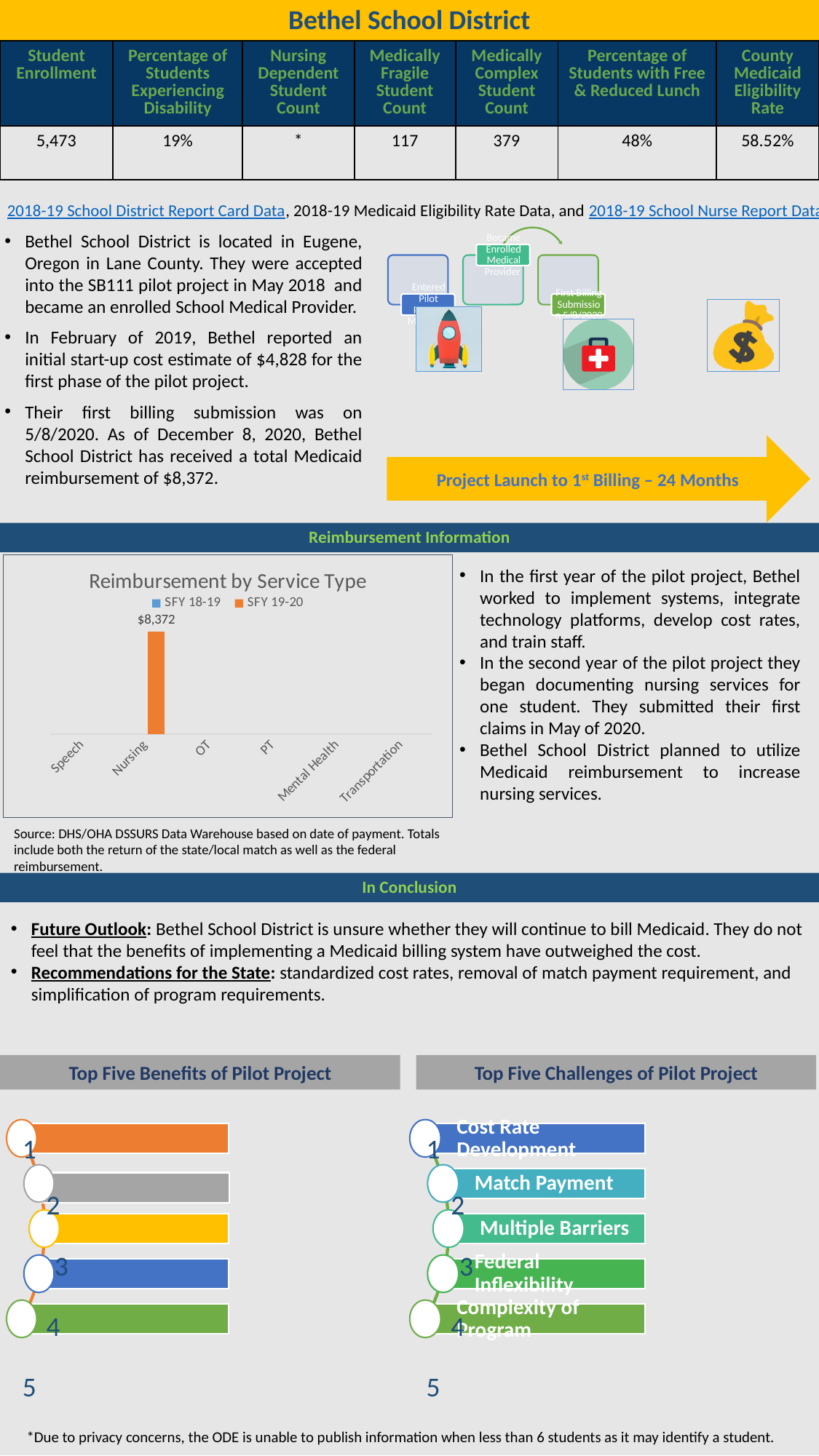
How many service type categories are shown on the x axis of the 'Reimbursement by Service Type' chart? 6 What are the two series names in the legend of the 'Reimbursement by Service Type' chart? SFY 18-19 and SFY 19-20 In the 'Reimbursement by Service Type' chart, what is the SFY 19-20 reimbursement value for Nursing? $8,372 Which service type has the highest reimbursement in the 'Reimbursement by Service Type' chart? Nursing What kind of chart is 'Reimbursement by Service Type'? bar chart Which category is listed last on the x axis of the 'Reimbursement by Service Type' chart? Transportation In the 'Reimbursement by Service Type' chart, which series does the only visible bar belong to? SFY 19-20 In the 'Reimbursement by Service Type' chart, is the reimbursement for Nursing or for Speech larger? Nursing How many series does the legend of the 'Reimbursement by Service Type' chart list? 2